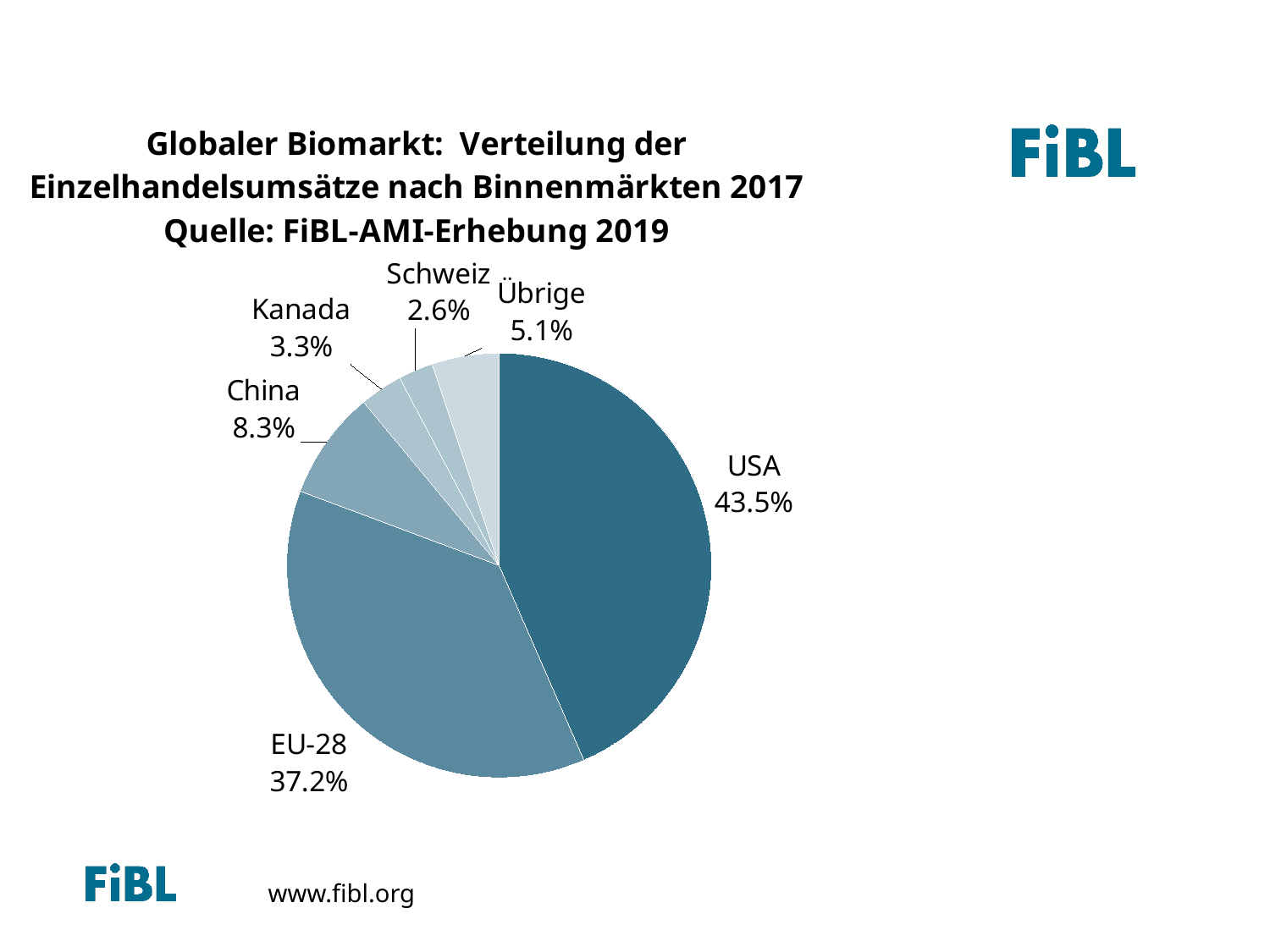
What share of the pie does USA have? 43.5% How many slices does the pie chart have? 6 Which category has the largest slice of the pie? USA Which slice is larger, China or Übrige? China What share of the pie does Kanada have? 3.3% What is the difference in percentage points between the USA and EU-28 slices? 6.3 What share of the pie does Schweiz have? 2.6% What share of the pie does EU-28 have? 37.2% Which category has the smallest slice of the pie? Schweiz What share of the pie does China have? 8.3% What kind of chart is shown on the slide? Pie chart What share of the pie does Übrige have? 5.1%